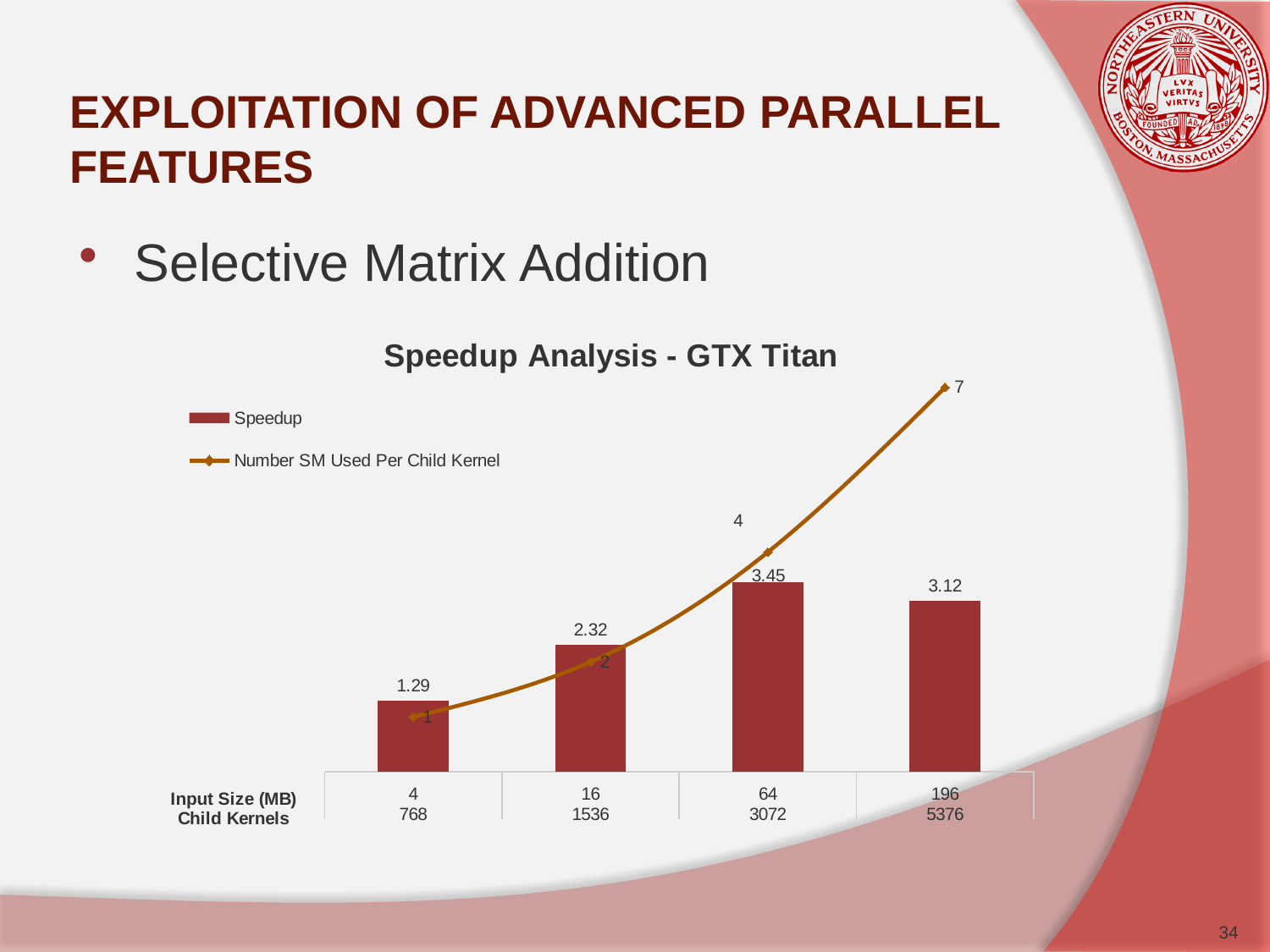
What is the Number SM Used Per Child Kernel for an input size of 64 MB? 4 Which has a larger Speedup, input size 64 MB or 196 MB? 64 What is the difference in Speedup between input sizes 64 MB and 4 MB? 2.16 Which input size has the highest Speedup? 64 How many series does the legend list? 2 What is the Speedup for an input size of 196 MB? 3.12 What is the title of the chart? Speedup Analysis - GTX Titan How many input sizes are shown on the x axis? 4 What is the Speedup for an input size of 16 MB? 2.32 What is the Number SM Used Per Child Kernel for an input size of 196 MB? 7 Does the Number SM Used Per Child Kernel rise or fall as input size increases? rise Which input size has the lowest Speedup? 4